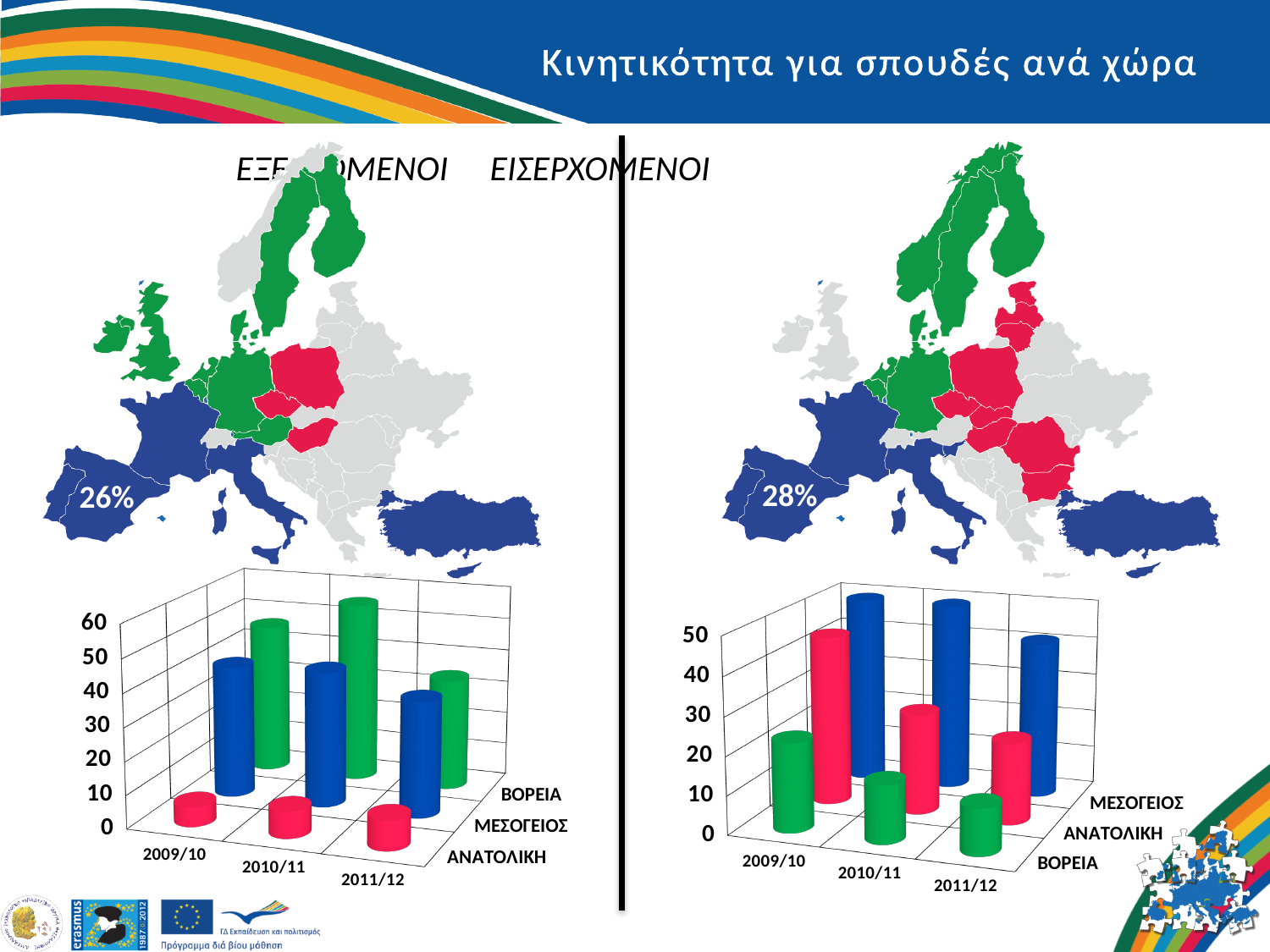
In the left chart (ΕΞΕΡΧΟΜΕΝΟΙ), is the value for ΑΝΑΤΟΛΙΚΗ in 2009/10 greater or less than 10? less In the left chart (ΕΞΕΡΧΟΜΕΝΟΙ), which series has the lowest bars across all years? ΑΝΑΤΟΛΙΚΗ In the right chart (ΕΙΣΕΡΧΟΜΕΝΟΙ), which series has the lowest bar in 2011/12? ΒΟΡΕΙΑ What kind of chart is the left chart (ΕΞΕΡΧΟΜΕΝΟΙ)? bar chart How many year categories are shown on the x axis of the left chart (ΕΞΕΡΧΟΜΕΝΟΙ)? 3 In the right chart (ΕΙΣΕΡΧΟΜΕΝΟΙ), is the value for ΑΝΑΤΟΛΙΚΗ in 2009/10 greater or less than 30? greater What is the highest value shown on the vertical axis of the left chart (ΕΞΕΡΧΟΜΕΝΟΙ)? 60 How many series are plotted in the right chart (ΕΙΣΕΡΧΟΜΕΝΟΙ)? 3 In the left chart (ΕΞΕΡΧΟΜΕΝΟΙ), which is larger for 2009/10, ΒΟΡΕΙΑ or ΑΝΑΤΟΛΙΚΗ? ΒΟΡΕΙΑ In the right chart (ΕΙΣΕΡΧΟΜΕΝΟΙ), which series has the highest bars across all years? ΜΕΣΟΓΕΙΟΣ In the left chart (ΕΞΕΡΧΟΜΕΝΟΙ), is the value for ΒΟΡΕΙΑ in 2010/11 greater or less than 40? greater In the right chart (ΕΙΣΕΡΧΟΜΕΝΟΙ), do the ΒΟΡΕΙΑ values rise or fall from 2009/10 to 2011/12? fall